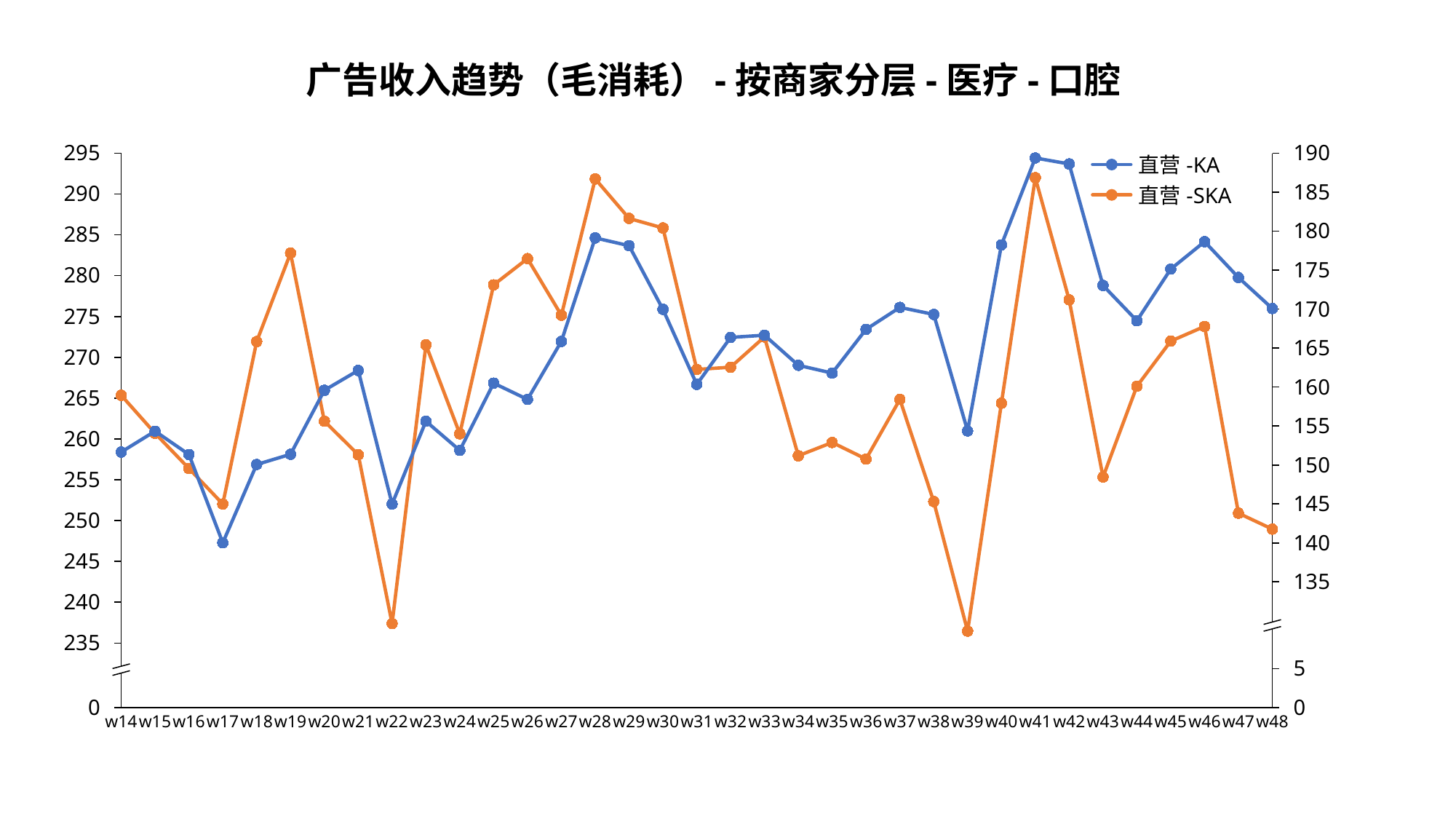
In which week does the 直营-SKA series reach its lowest value? w39 Is the 直营-SKA value for w22 greater or less than 140? less Is the 直营-KA value for w17 greater or less than 250? less Is the 直营-KA value for w28 greater or less than 280? greater In which week does the 直营-KA series reach its lowest value? w17 How many weeks are plotted along the x axis? 35 Does the 直营-KA series rise or fall from w39 to w41? rise In which week does the 直营-SKA series reach its highest value? w41 What kind of chart is shown on the slide? line chart How many series does the legend list? 2 Which is larger for the 直营-KA series, the value at w41 or the value at w17? w41